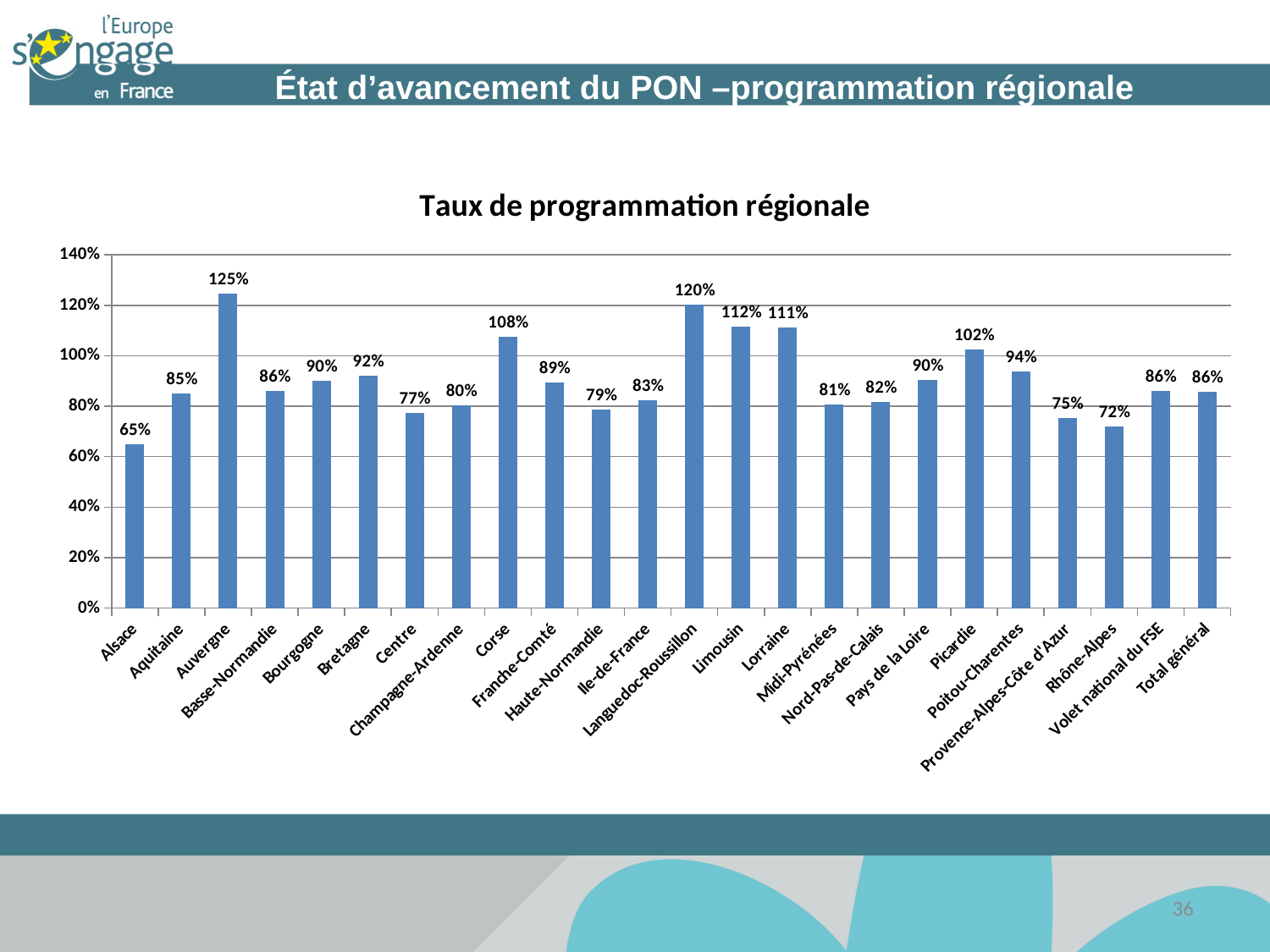
What kind of chart is this? bar chart What is the value for Auvergne? 125% What is the difference between the values for Auvergne and Alsace? 60% What is the value for Languedoc-Roussillon? 120% What is the value for Rhône-Alpes? 72% How many categories are shown on the x axis? 24 Which is larger, the value for Corse or the value for Picardie? Corse What is the title of the chart? Taux de programmation régionale What is the value for Total général? 86% Which category has the lowest value? Alsace Which category has the highest value? Auvergne Is the value for Limousin greater or less than 100%? greater